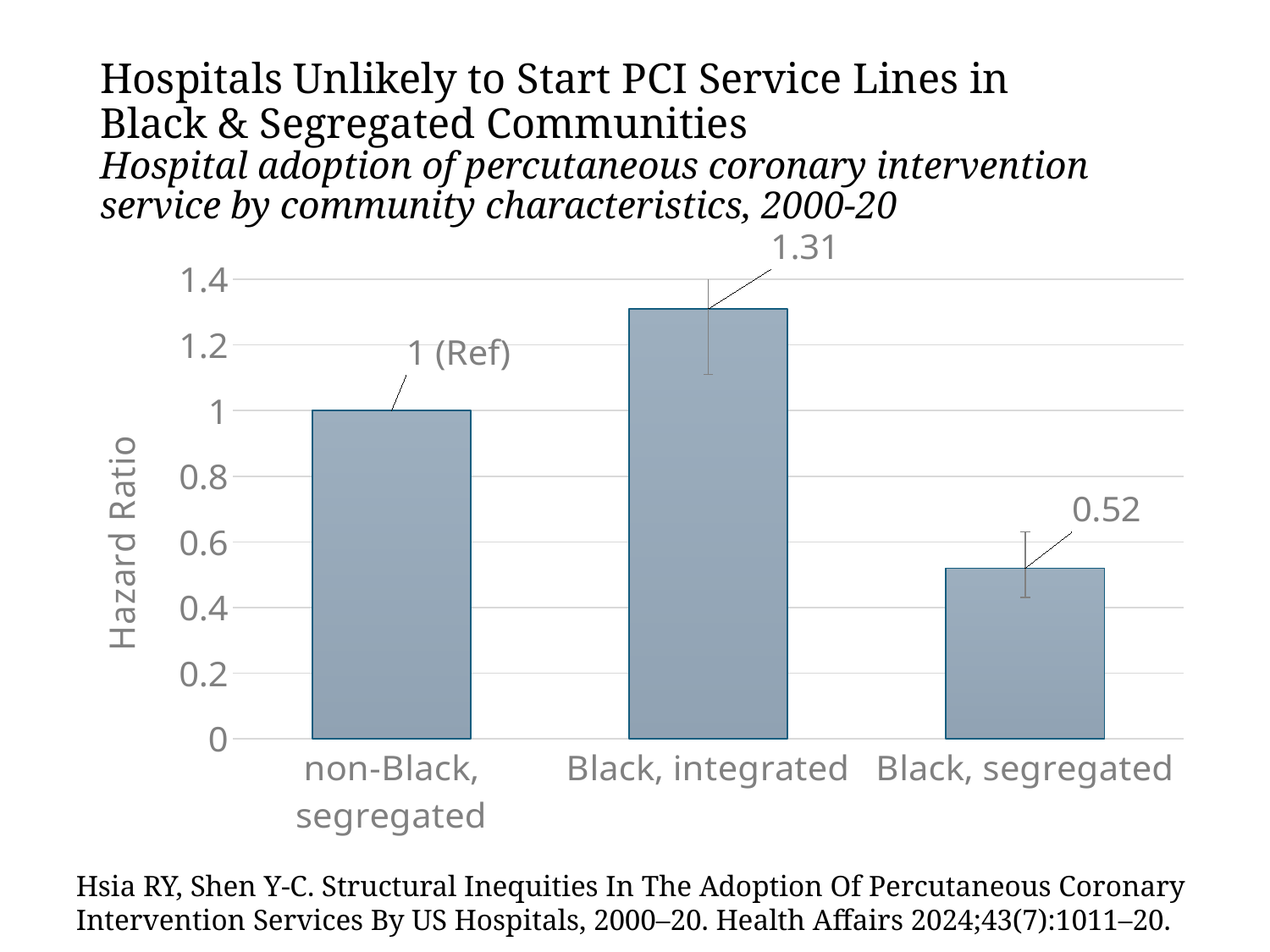
Which community type has the lowest hazard ratio? Black, segregated Which has a larger hazard ratio: non-Black, segregated or Black, segregated? non-Black, segregated Is the hazard ratio for Black, segregated communities greater or less than 0.6? less What is the data label shown for non-Black, segregated communities? 1 (Ref) How many community categories are shown in the chart? 3 What time period does the chart subtitle say the data covers? 2000-20 What is the difference between the hazard ratios for Black, integrated and Black, segregated communities? 0.79 What is the label of the y axis? Hazard Ratio Which community type has the highest hazard ratio? Black, integrated What is the hazard ratio for Black, segregated communities? 0.52 What is the hazard ratio for Black, integrated communities? 1.31 What kind of chart is shown on the slide? bar chart